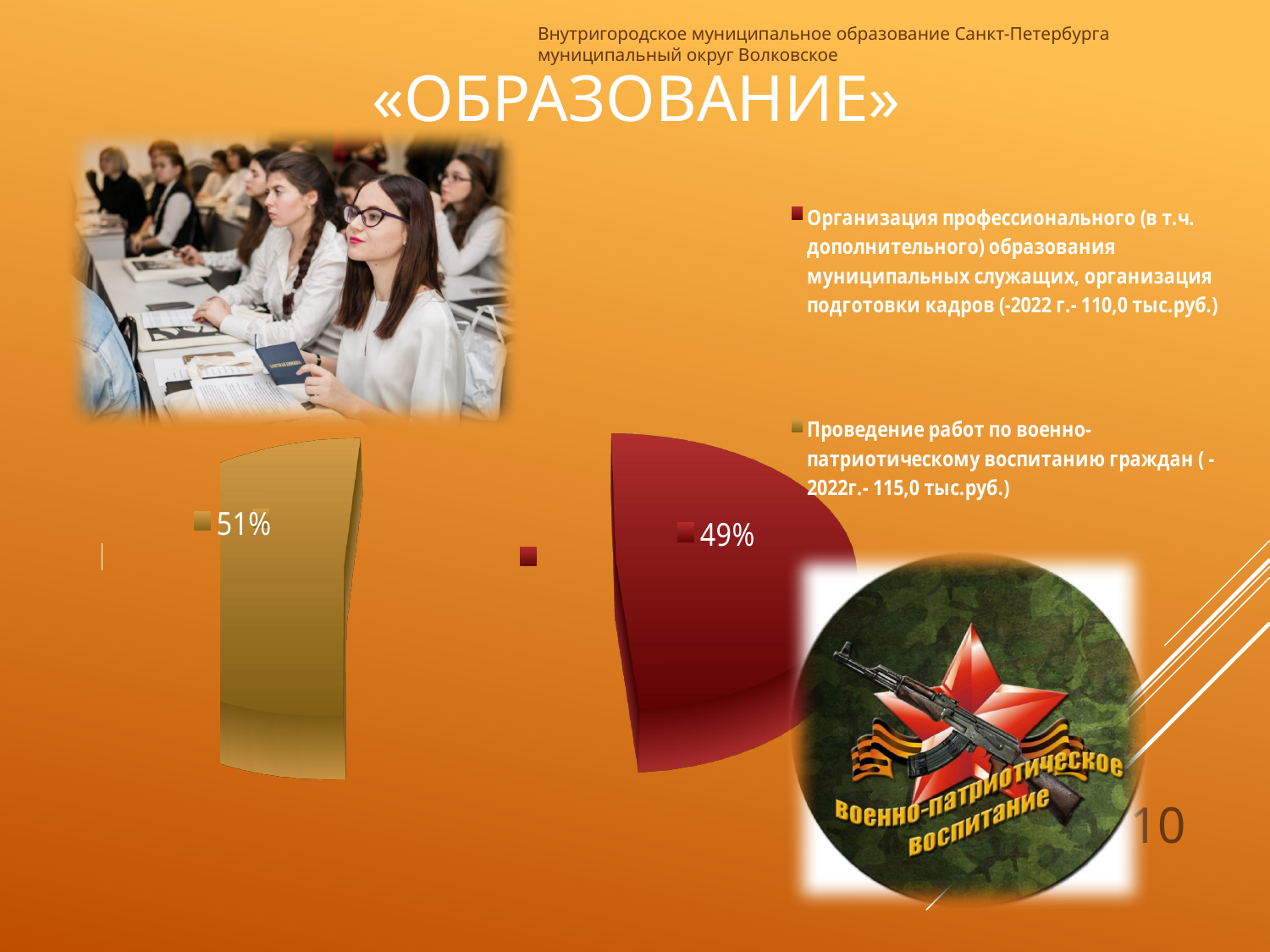
Which slice of the pie chart is the largest? Проведение работ по военно-патриотическому воспитанию граждан (51%) What is the difference in percentage points between the two slices of the pie chart? 2 percentage points Which slice of the pie chart is the smallest? Организация профессионального (в т.ч. дополнительного) образования муниципальных служащих (49%) According to the legend, what amount in 2022 is given for the organisation of professional education of municipal employees? 110,0 тыс.руб. What share of the pie is shown for the red slice (Организация профессионального образования муниципальных служащих)? 49% According to the legend, what amount in 2022 is given for military-patriotic education work? 115,0 тыс.руб. What kind of chart is shown on the slide? pie chart How many slices does the pie chart have? 2 How many entries does the legend of the pie chart list? 2 Which is larger: the share for military-patriotic education work or the share for professional education of municipal employees? military-patriotic education work (51%) What is the total of the two percentage labels shown on the pie chart? 100% What share of the pie is shown for the slice labelled with the olive/gold colour (Проведение работ по военно-патриотическому воспитанию граждан)? 51%